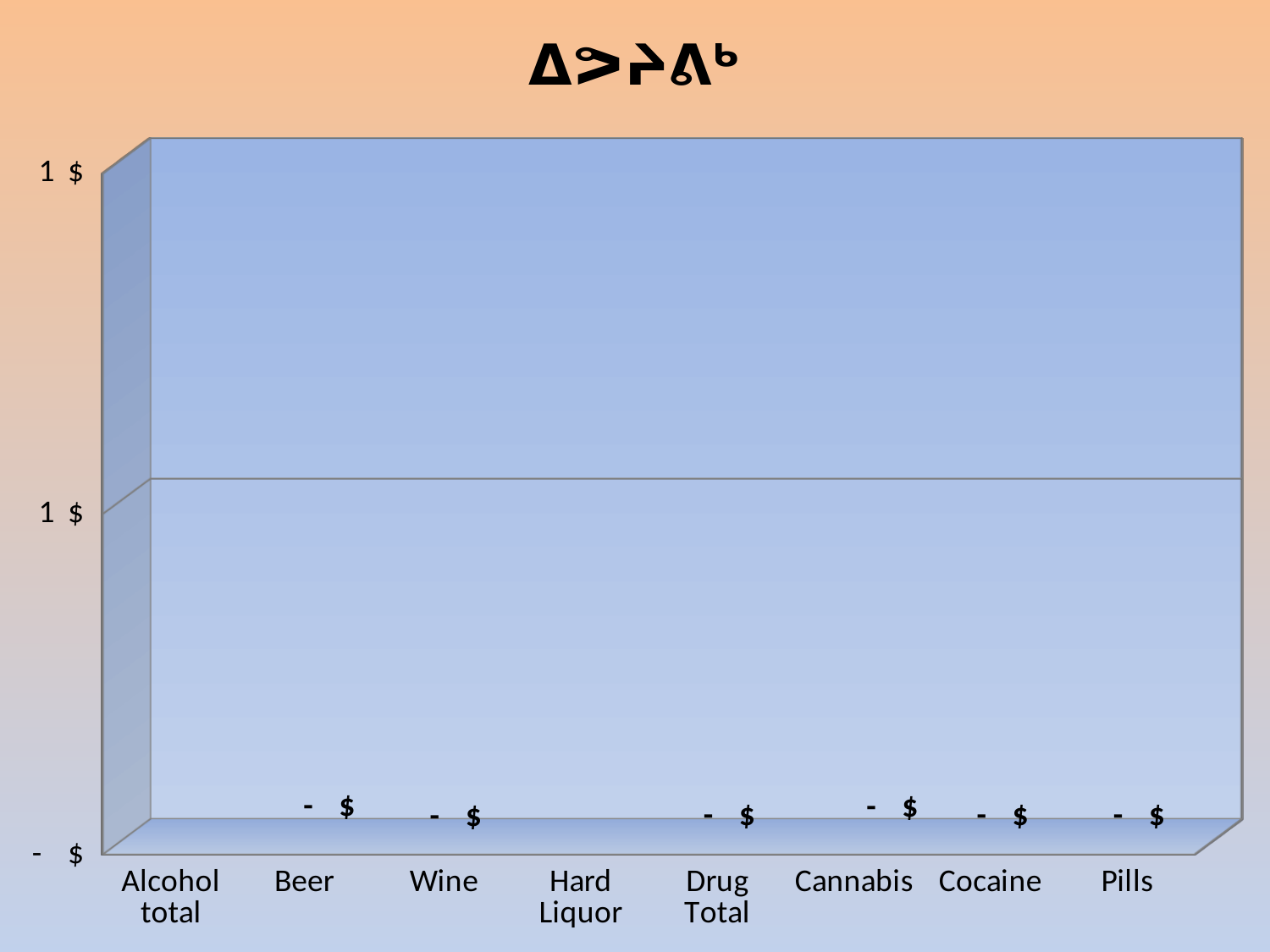
What is the data label shown for Beer? - $ What is the data label shown for Cannabis? - $ Is the value for Cocaine greater or less than 1 $? less What kind of chart is shown on the slide? bar chart What is the data label shown for Cocaine? - $ What is the data label shown for Wine? - $ What is the first category label on the x axis? Alcohol total What is the last category label on the x axis? Pills Is the value for Beer greater or less than 1 $? less What is the data label shown for Drug Total? - $ What is the data label shown for Pills? - $ How many categories are shown along the x axis of the chart? 8